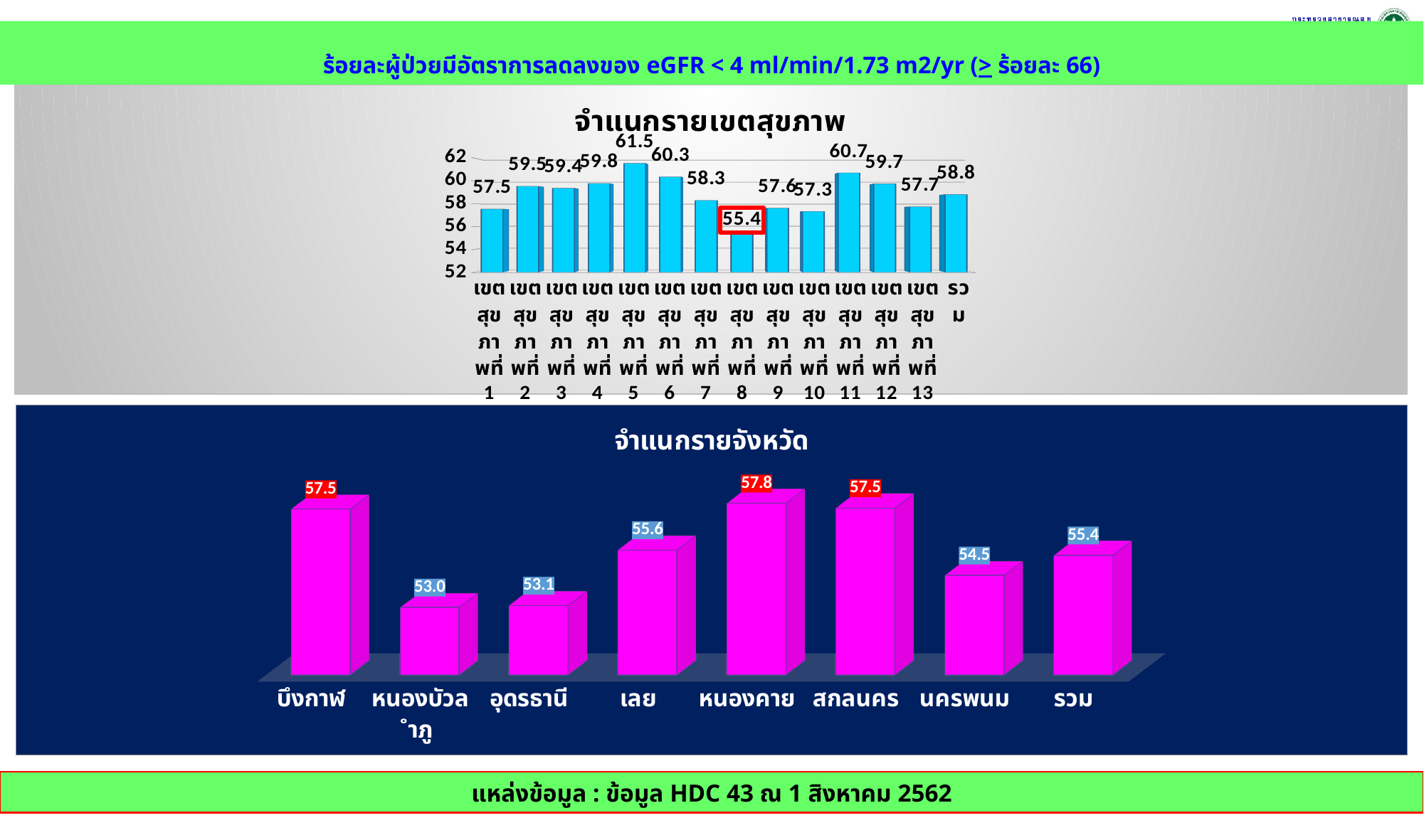
In the bottom chart (จำแนกรายจังหวัด), which is larger, the value for เลย or the value for นครพนม? เลย In the top chart (จำแนกรายเขตสุขภาพ), what is the value for รวม? 58.8 In the top chart (จำแนกรายเขตสุขภาพ), what is the value for เขตสุขภาพที่ 8? 55.4 In the top chart (จำแนกรายเขตสุขภาพ), which health region has the lowest value? เขตสุขภาพที่ 8 What kind of chart is the bottom chart (จำแนกรายจังหวัด)? Bar chart In the bottom chart (จำแนกรายจังหวัด), which province has the lowest value? หนองบัวลำภู In the bottom chart (จำแนกรายจังหวัด), how many bars are shown? 8 In the top chart (จำแนกรายเขตสุขภาพ), which health region has the highest value? เขตสุขภาพที่ 5 In the bottom chart (จำแนกรายจังหวัด), what is the value for หนองคาย? 57.8 In the top chart (จำแนกรายเขตสุขภาพ), what is the value for เขตสุขภาพที่ 5? 61.5 In the bottom chart (จำแนกรายจังหวัด), which province has the highest value? หนองคาย In the top chart (จำแนกรายเขตสุขภาพ), what is the difference between เขตสุขภาพที่ 11 and เขตสุขภาพที่ 10? 3.4